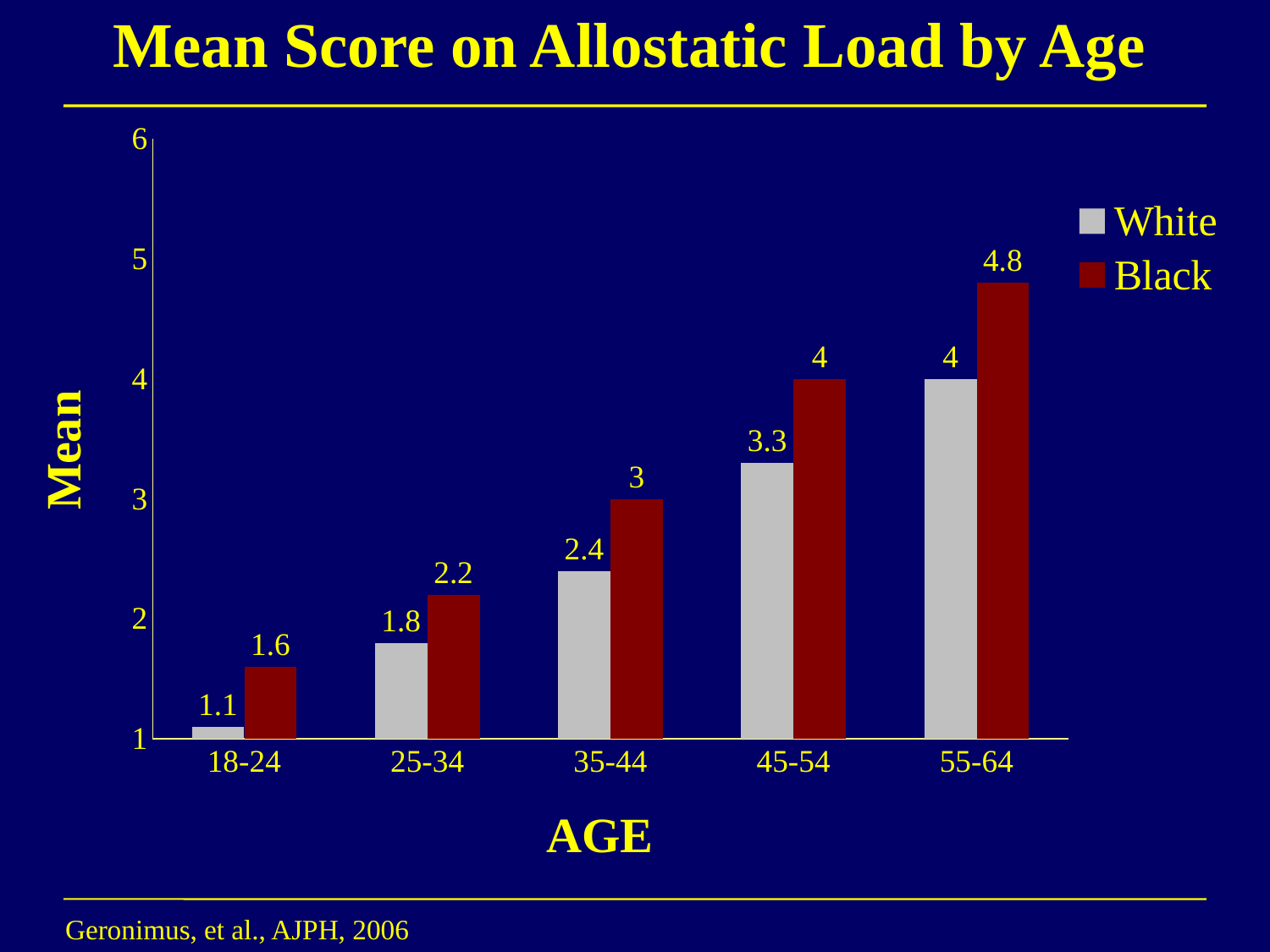
How many age groups are shown on the x axis? 5 What is the difference between the Black and White mean scores in the 45-54 age group? 0.7 How many series does the legend list? 2 Do the mean scores for the White series rise or fall as age increases? Rise What is the mean allostatic load score for Black in the 18-24 age group? 1.6 Which age group has the highest mean score for the Black series? 55-64 What is the mean allostatic load score for Black in the 55-64 age group? 4.8 What is the difference between the Black and White mean scores in the 55-64 age group? 0.8 What kind of chart is shown on the slide? Bar chart Which age group has the lowest mean score for the White series? 18-24 In the 25-34 age group, which series has the larger mean score, White or Black? Black What is the mean allostatic load score for White in the 35-44 age group? 2.4